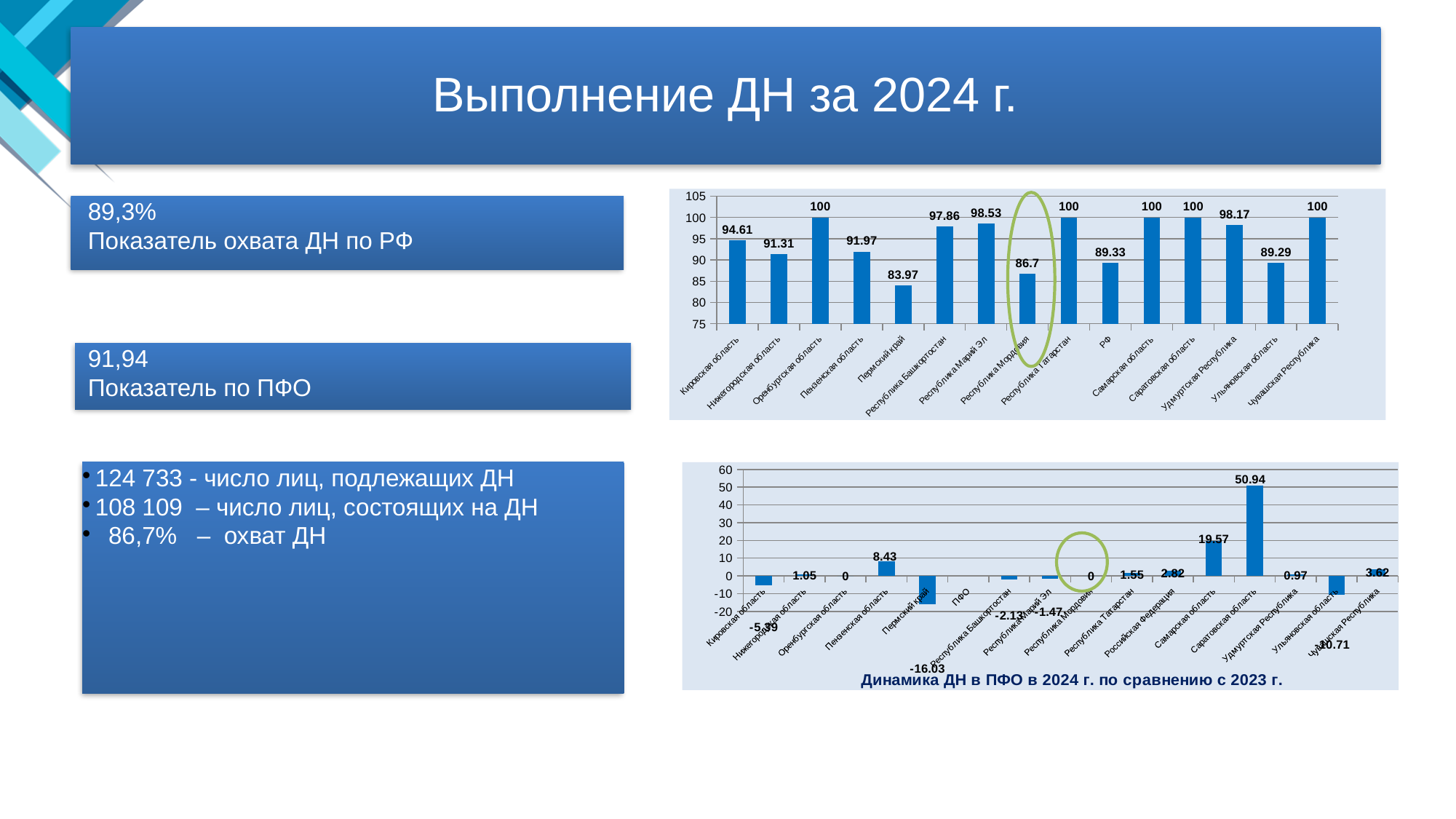
What type of chart is the upper chart? bar chart In the upper chart, which region has the lowest value? Пермский край In the upper chart, which is larger: Кировская область or Ульяновская область? Кировская область In the chart 'Динамика ДН в ПФО в 2024 г. по сравнению с 2023 г.', what is the value for Пензенская область? 8.43 In the chart 'Динамика ДН в ПФО в 2024 г. по сравнению с 2023 г.', which region has the lowest value? Пермский край In the upper chart, what is the value for РФ? 89.33 In the chart 'Динамика ДН в ПФО в 2024 г. по сравнению с 2023 г.', which region has the highest value? Саратовская область In the chart 'Динамика ДН в ПФО в 2024 г. по сравнению с 2023 г.', what is the value for Самарская область? 19.57 In the upper chart, what is the value for Республика Мордовия? 86.7 In the upper chart, what is the difference between Республика Марий Эл and Нижегородская область? 7.22 In the upper chart, what is the value for Пермский край? 83.97 How many regions/categories are shown in the upper chart? 15